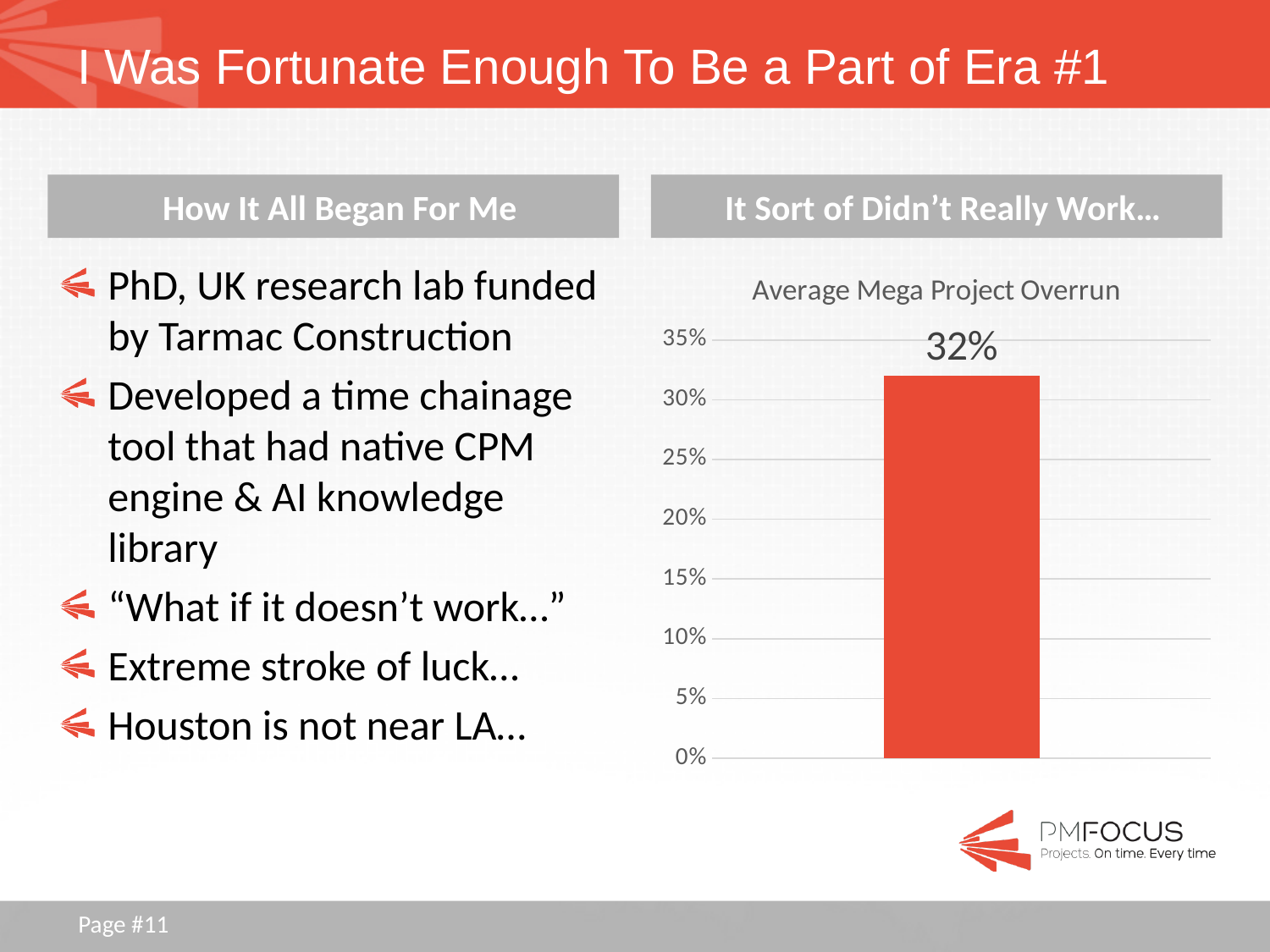
Is the value of the bar greater or less than 30%? greater What is the value shown on the bar in the chart? 32% What kind of chart is shown on the slide? bar chart What is the average mega project overrun according to the chart? 32% Is the value of the bar greater or less than 35%? less What is the title of the chart? Average Mega Project Overrun How many bars are plotted in the chart? 1 What is the highest value shown on the vertical axis of the chart? 35%